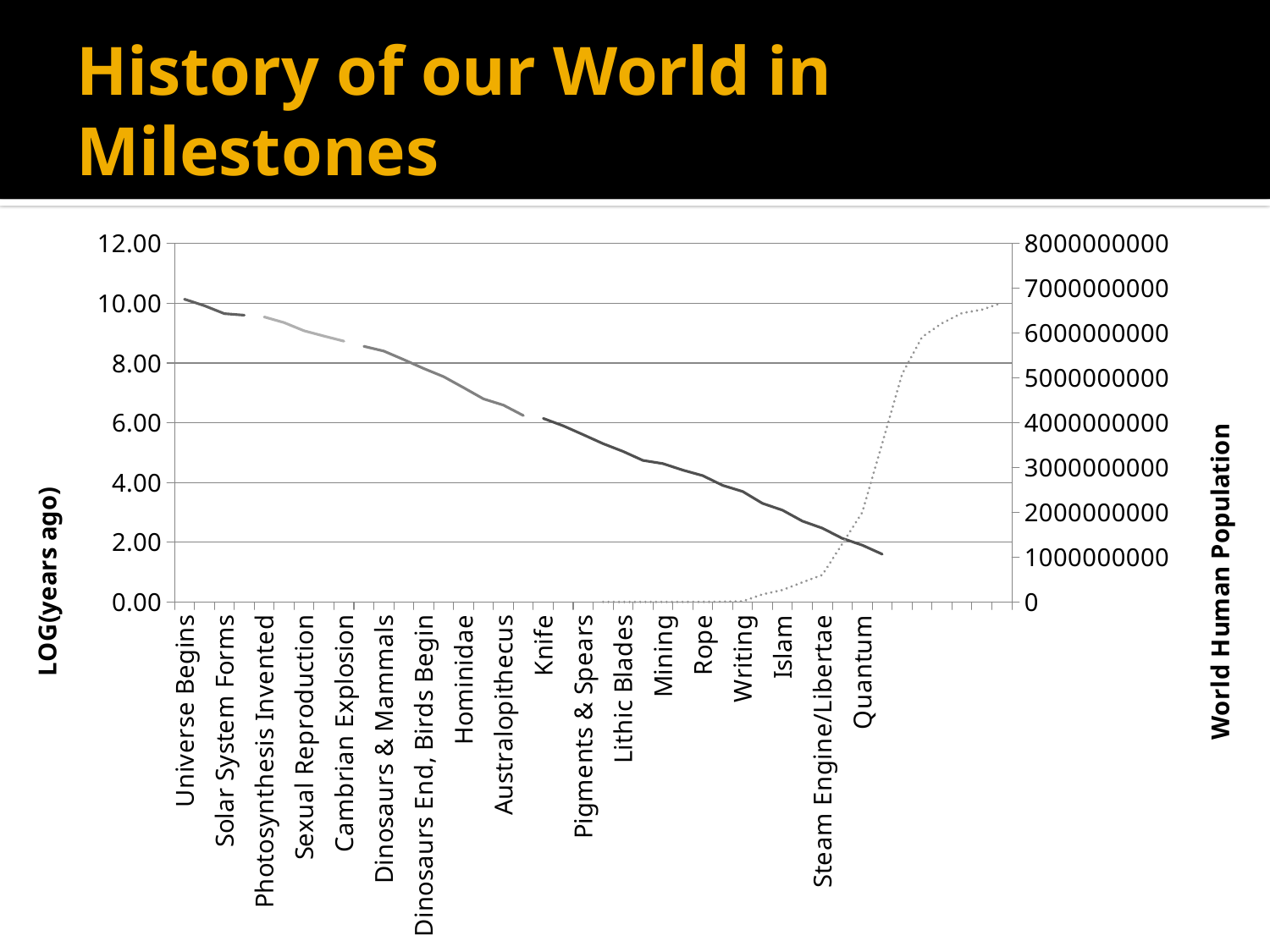
Is the LOG(years ago) value for Writing greater or less than 4.00? less What is the title of the right vertical axis? World Human Population Which labeled milestone has the lowest LOG(years ago) value? Quantum Which labeled milestone has the highest LOG(years ago) value? Universe Begins Is the LOG(years ago) value for Pigments & Spears greater or less than 6.00? less Is the LOG(years ago) value for Universe Begins greater or less than 8.00? greater Does the LOG(years ago) line rise or fall as you move from Universe Begins toward Quantum along the x axis? fall What kind of chart is shown on the slide? line chart Which has the larger LOG(years ago) value, Knife or Rope? Knife What is the title of the left vertical axis? LOG(years ago)